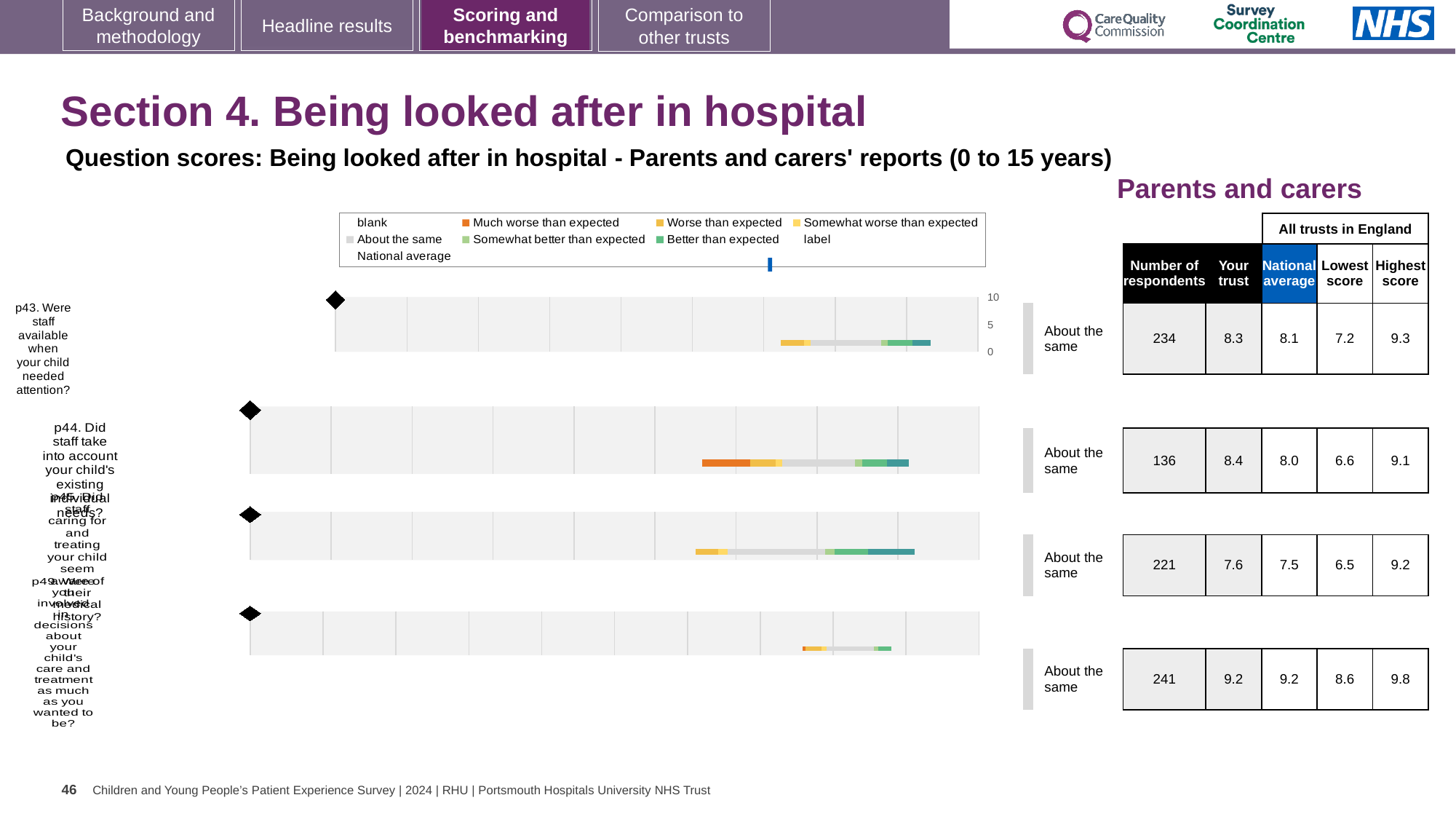
What is the Highest score across all trusts in England shown for the third chart (p45)? 9.2 Which question on the slide has the highest 'Your trust' score? p49 What is the Lowest score across all trusts in England shown for p44? 6.6 For p44, what is the difference between the 'Your trust' score and the National average? 0.4 Which question on the slide has the lowest 'Your trust' score? p45 In the table next to the chart for p44 (Did staff take into account your child's existing individual needs?), what is the National average score? 8.0 How many respondents are listed for the bottom chart (p49, involvement in decisions about your child's care and treatment)? 241 What kind of chart is used to show each question's score on the slide? Bar chart What benchmark category is shown beside the chart for p43? About the same For p43, which is larger: the 'Your trust' score or the National average? Your trust How many question charts are shown on the slide? 4 In the table next to the chart for p43 (Were staff available when your child needed attention?), what is the 'Your trust' score? 8.3